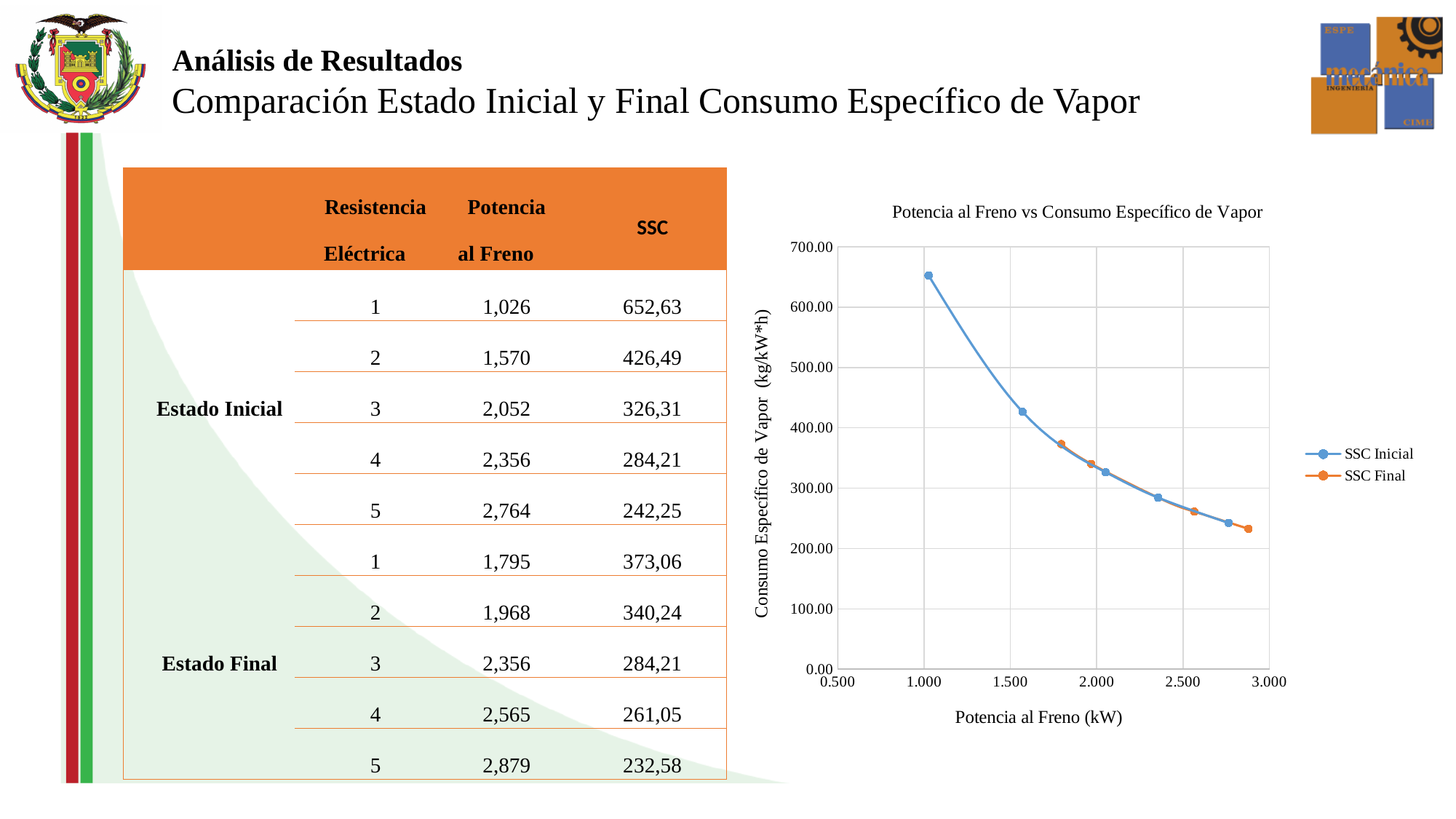
Does the Consumo Específico de Vapor rise or fall as Potencia al Freno increases? fall Which series contains the highest plotted value on the chart? SSC Inicial How many data points does the SSC Final series have? 5 Is the first SSC Final point (near 1.800 kW) greater or less than 400? less What kind of chart is shown on the slide? line chart How many series does the chart legend list? 2 Is the SSC Inicial value at the lowest Potencia al Freno (about 1.000 kW) greater or less than 600? greater Is the SSC Final value at the highest Potencia al Freno (near 2.900 kW) greater or less than 300? less Which is larger: the SSC Inicial value at about 1.570 kW or the SSC Final value at about 1.795 kW? SSC Inicial at 1.570 kW What is the title of the chart? Potencia al Freno vs Consumo Específico de Vapor What are the names of the two series in the chart legend? SSC Inicial and SSC Final How many data points does the SSC Inicial series have? 5